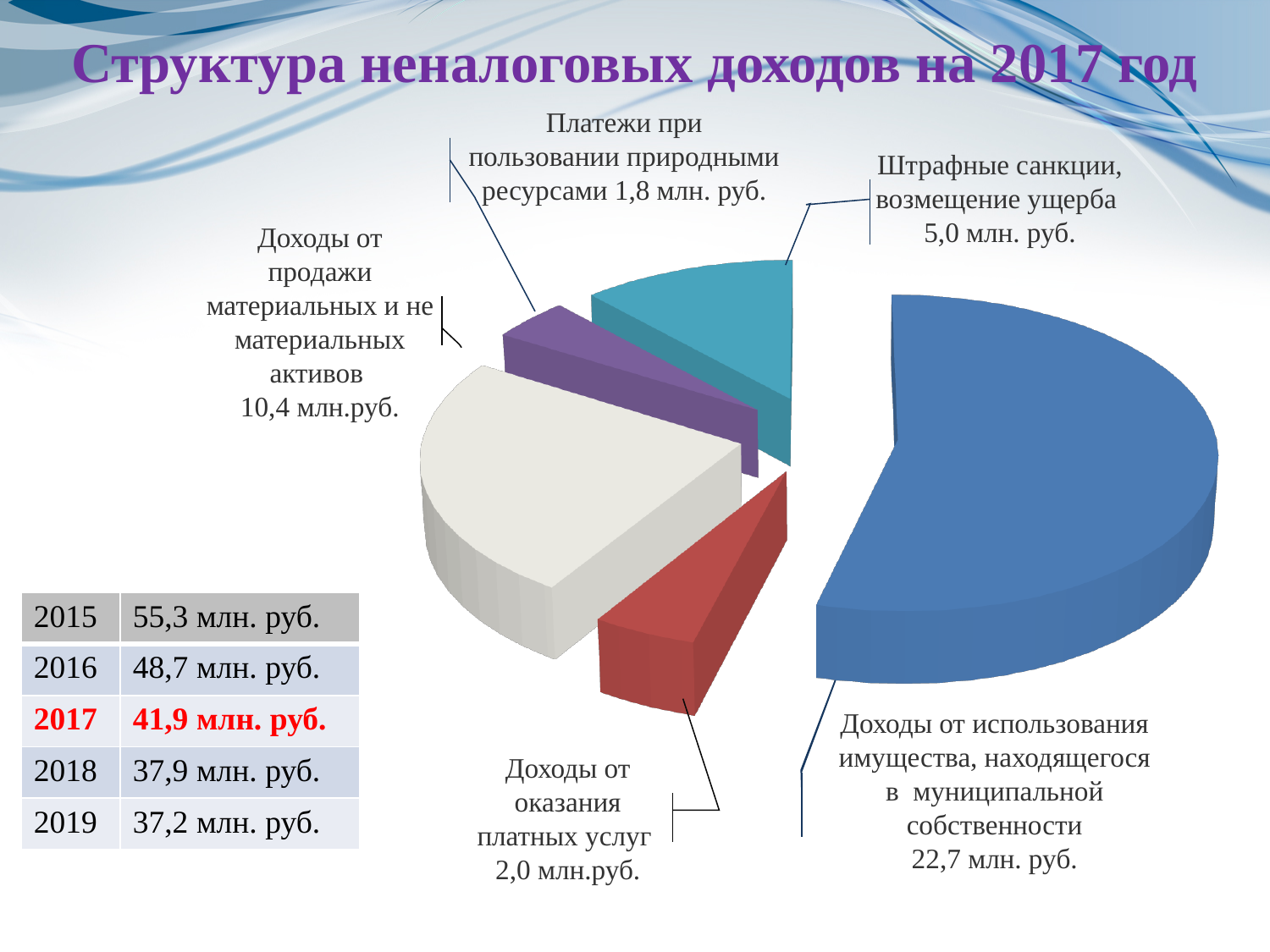
Which is larger: «Штрафные санкции, возмещение ущерба» or «Доходы от оказания платных услуг»? Штрафные санкции, возмещение ущерба What is the difference between «Доходы от использования имущества» (22,7 млн. руб.) and «Доходы от продажи материальных и не материальных активов» (10,4 млн.руб.)? 12,3 млн. руб. What kind of chart is shown on the slide? Pie chart What is the title of the chart on the slide? Структура неналоговых доходов на 2017 год How many slices does the pie chart have? 5 What is the value for «Доходы от продажи материальных и не материальных активов»? 10,4 млн.руб. Which category has the smallest slice of the pie? Платежи при пользовании природными ресурсами What is the total of all five slices of the pie chart? 41,9 млн. руб. What is the value for «Платежи при пользовании природными ресурсами»? 1,8 млн. руб. What is the value for «Доходы от использования имущества, находящегося в муниципальной собственности»? 22,7 млн. руб. Which category has the largest slice of the pie? Доходы от использования имущества, находящегося в муниципальной собственности What is the value for «Штрафные санкции, возмещение ущерба»? 5,0 млн. руб.